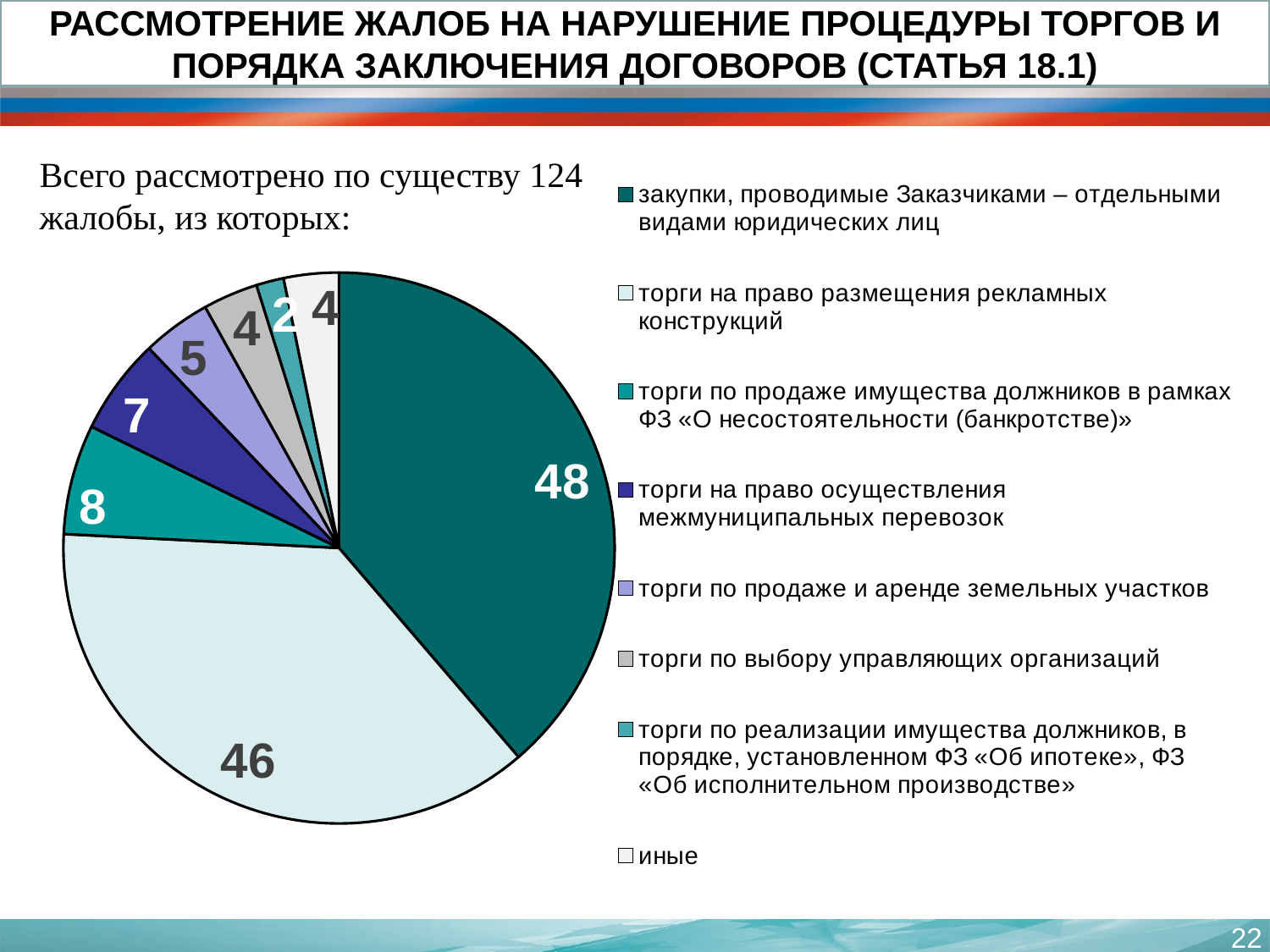
What is the value for «торги по продаже имущества должников в рамках ФЗ «О несостоятельности (банкротстве)»»? 8 Which is larger: the value for «торги по продаже и аренде земельных участков» or the value for «торги по выбору управляющих организаций»? торги по продаже и аренде земельных участков What is the total number of complaints considered, as stated on the slide? 124 What is the difference between the values for «закупки, проводимые Заказчиками – отдельными видами юридических лиц» and «торги на право размещения рекламных конструкций»? 2 What is the value for «торги на право размещения рекламных конструкций»? 46 How many slices does the pie chart have? 8 Which category has the smallest slice of the pie? торги по реализации имущества должников, в порядке, установленном ФЗ «Об ипотеке», ФЗ «Об исполнительном производстве» What kind of chart is shown on the slide? pie chart What is the value for «торги на право осуществления межмуниципальных перевозок»? 7 Which category has the largest slice of the pie? закупки, проводимые Заказчиками – отдельными видами юридических лиц How many entries does the legend of the pie chart list? 8 What is the value for «закупки, проводимые Заказчиками – отдельными видами юридических лиц»? 48